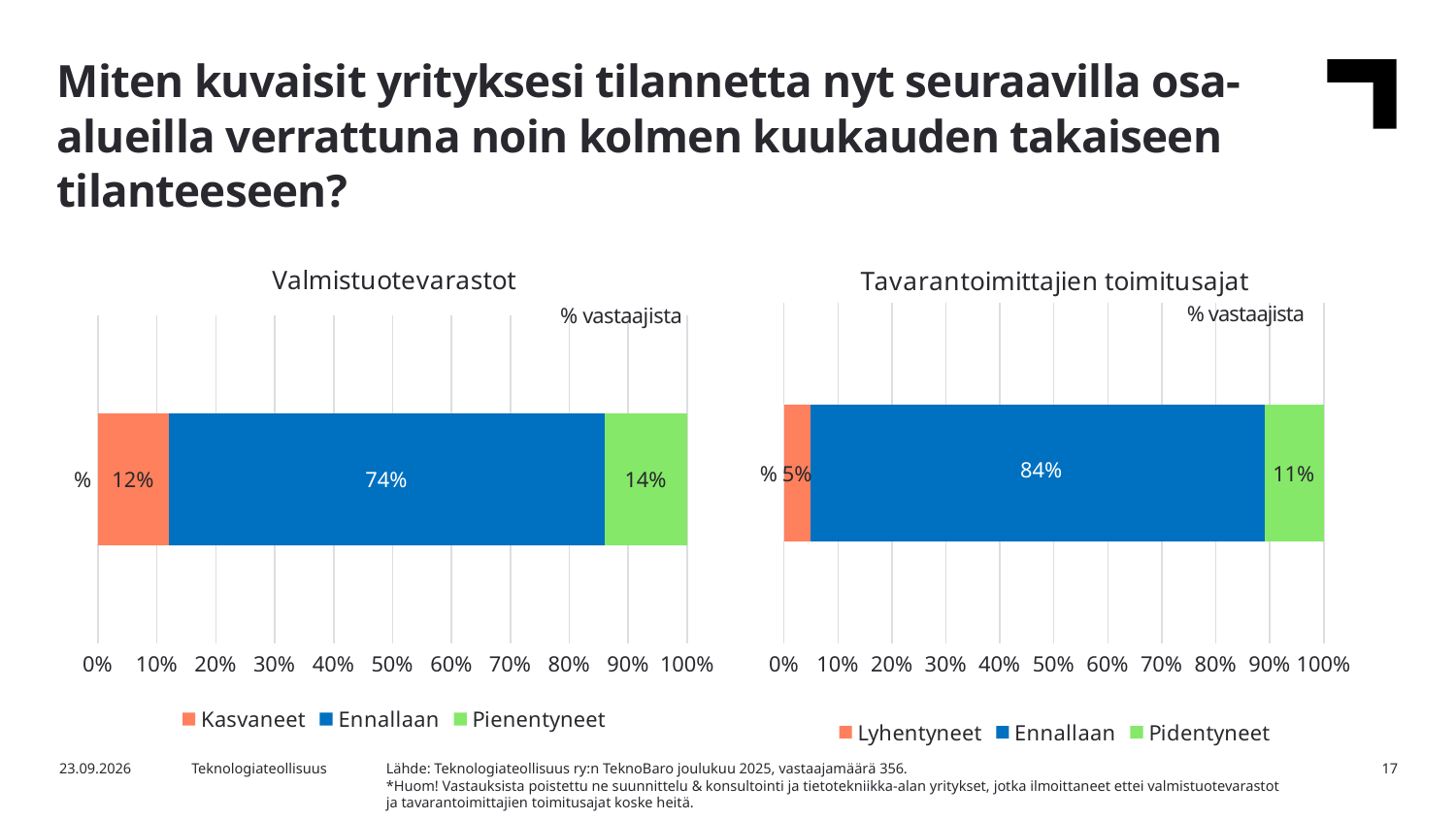
In the 'Tavarantoimittajien toimitusajat' chart, what percentage of respondents answered 'Pidentyneet'? 11% In the 'Tavarantoimittajien toimitusajat' chart, what is the difference between the 'Ennallaan' and 'Pidentyneet' shares? 73 percentage points What type of chart is the 'Valmistuotevarastot' chart? Stacked bar chart Which is larger: the 'Ennallaan' share in the 'Valmistuotevarastot' chart or the 'Ennallaan' share in the 'Tavarantoimittajien toimitusajat' chart? Tavarantoimittajien toimitusajat In the 'Valmistuotevarastot' chart, what percentage of respondents answered 'Ennallaan'? 74% In the 'Valmistuotevarastot' chart, what is the difference between the 'Pienentyneet' and 'Kasvaneet' shares? 2 percentage points In the 'Valmistuotevarastot' chart, what is the total of the three segments in the stacked bar? 100% How many series does the legend of the 'Tavarantoimittajien toimitusajat' chart list? 3 In the 'Valmistuotevarastot' chart, what percentage of respondents answered 'Kasvaneet'? 12% In the 'Tavarantoimittajien toimitusajat' chart, what percentage of respondents answered 'Lyhentyneet'? 5% In the 'Tavarantoimittajien toimitusajat' chart, which response has the smallest share? Lyhentyneet In the 'Valmistuotevarastot' chart, which response has the largest share? Ennallaan